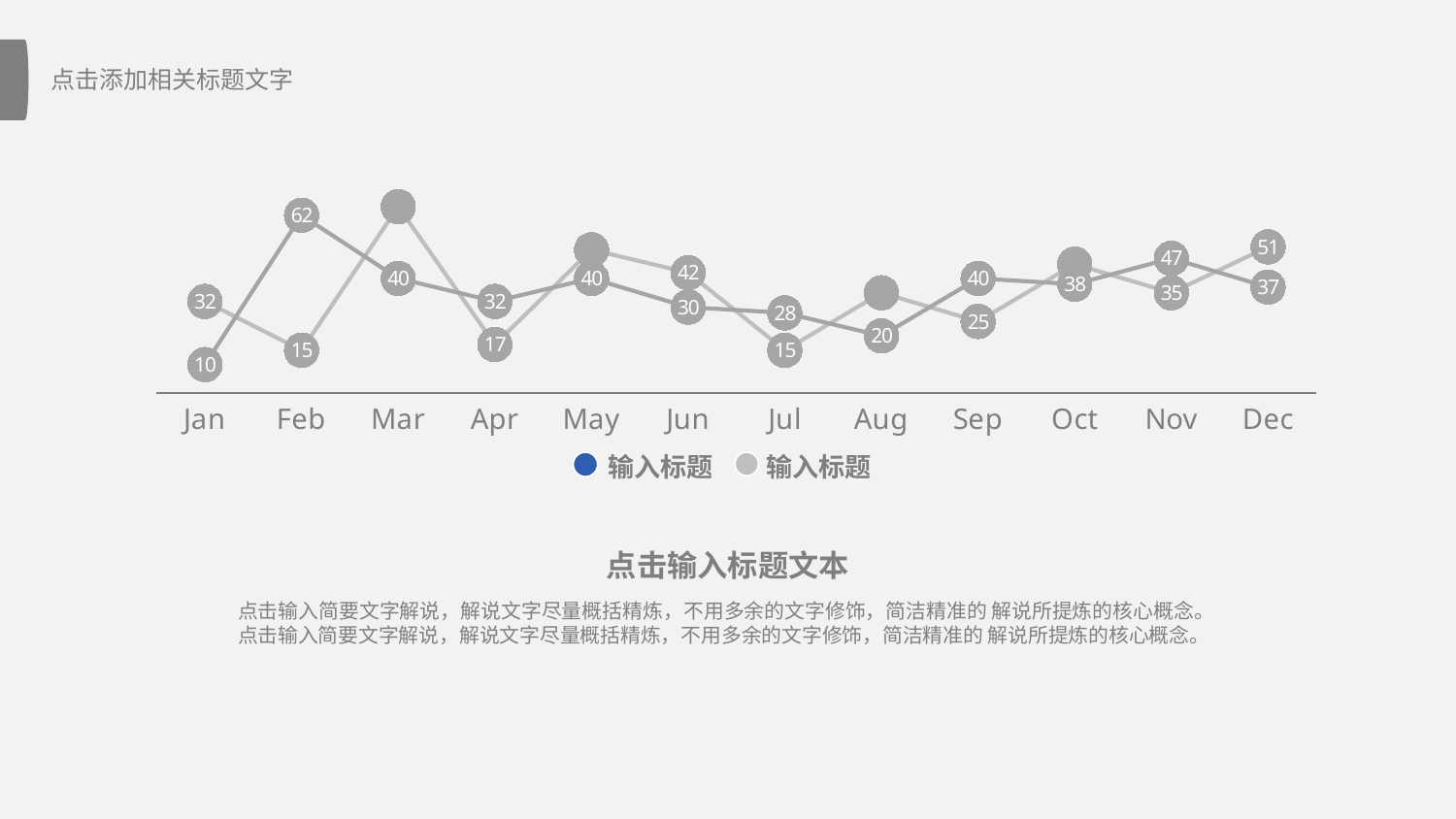
How many months are shown along the x axis of the chart? 12 What is the difference between the two values labeled at Feb (62 and 15)? 47 What is the higher of the two values labeled at Feb? 62 What is the lower of the two values labeled at Feb? 15 What text is used for both legend entries of the chart? 输入标题 What is the largest data label printed on the chart? 62 What are the two data labels shown for Jan? 32 and 10 At Jun, which of the two labeled values is larger, 42 or 30? 42 What kind of chart is shown on the slide? line chart What are the two data labels shown for Dec? 51 and 37 Which month has the lowest value on the chart? Jan How many series does the chart legend list? 2